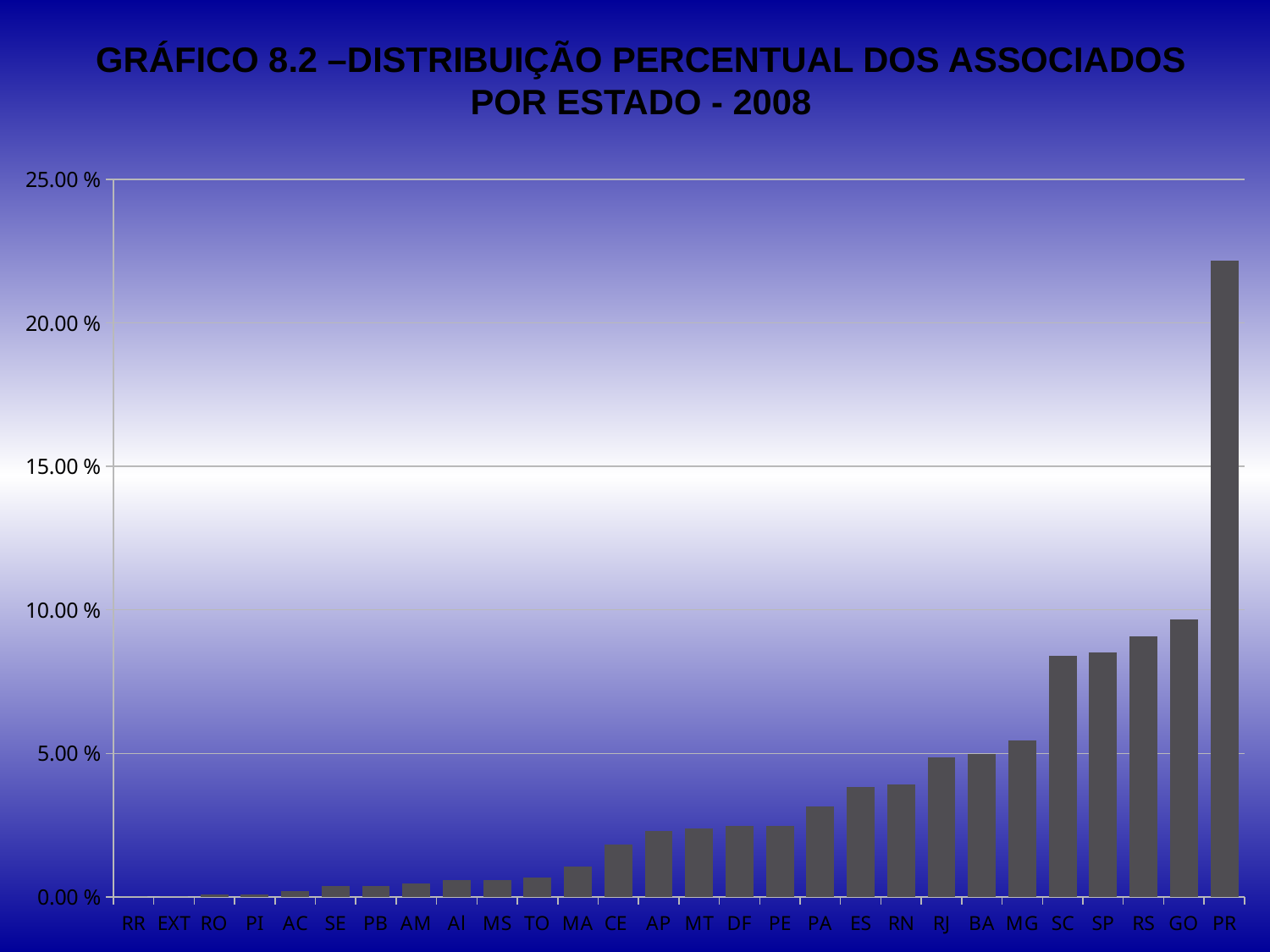
What kind of chart is shown on the slide? bar chart Is the value for GO greater or less than 10.00 %? less Which state has the highest percentage of associados? PR What is the title of the chart? GRÁFICO 8.2 –DISTRIBUIÇÃO PERCENTUAL DOS ASSOCIADOS POR ESTADO - 2008 Which has a larger value, MG or SC? SC Which has a larger value, PR or GO? PR Do the values generally rise or fall from left to right along the x axis? rise Is the value for PR greater or less than 20.00 %? greater Is the value for PA greater or less than 5.00 %? less How many categories are shown on the x axis? 28